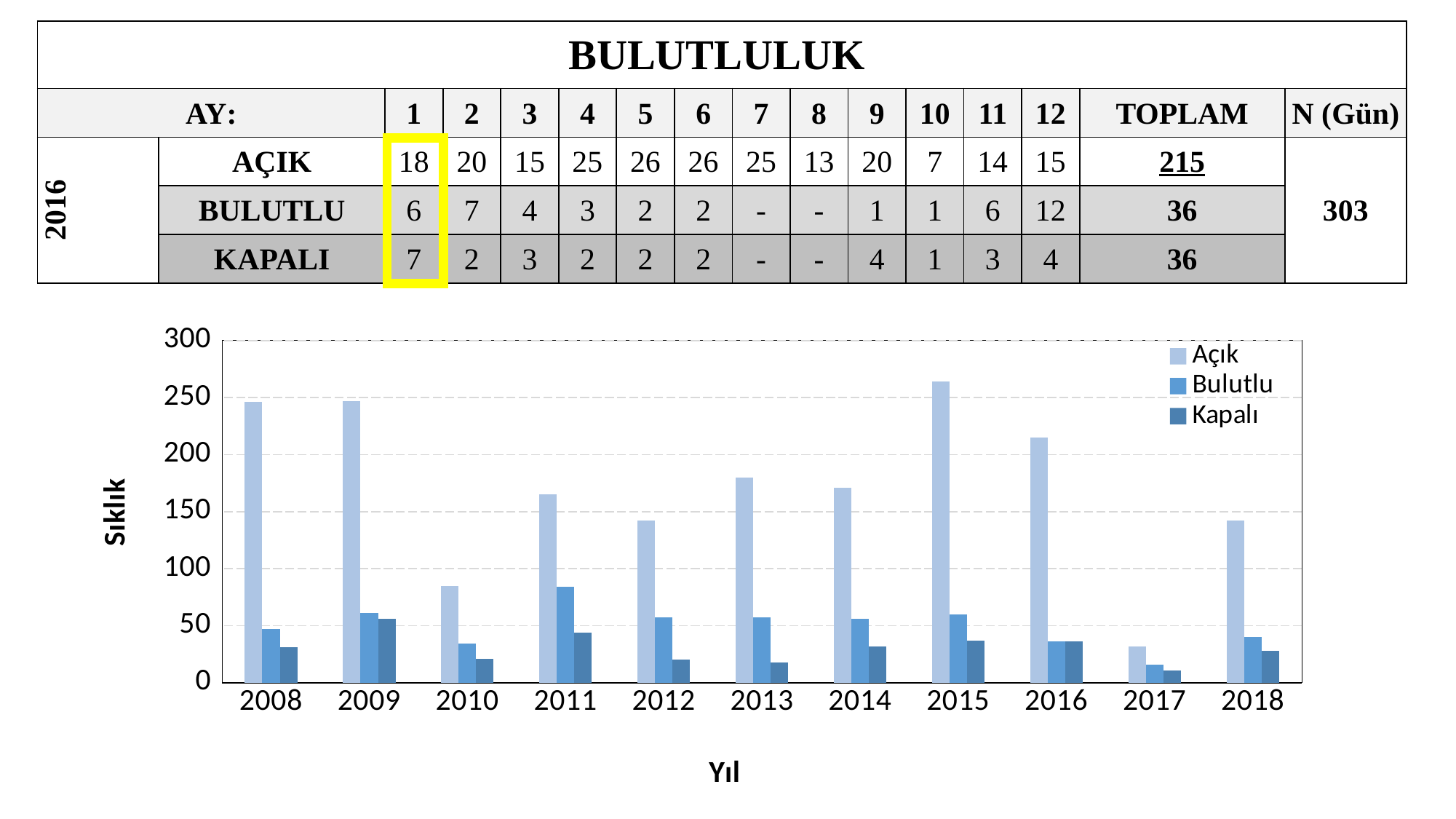
Is the Açık value for 2010 greater or less than 100? less Does the Açık value rise or fall from 2015 to 2017? fall In which year is the Açık bar the lowest? 2017 In which year is the Açık bar the highest? 2015 How many years are shown on the x axis of the chart? 11 What is the title of the chart's y axis? Sıklık Is the Kapalı value for 2013 greater or less than 50? less Which year has the larger Açık value, 2008 or 2012? 2008 What kind of chart is shown on the slide? bar chart How many series does the chart legend list? 3 Is the Bulutlu value for 2011 greater or less than 50? greater